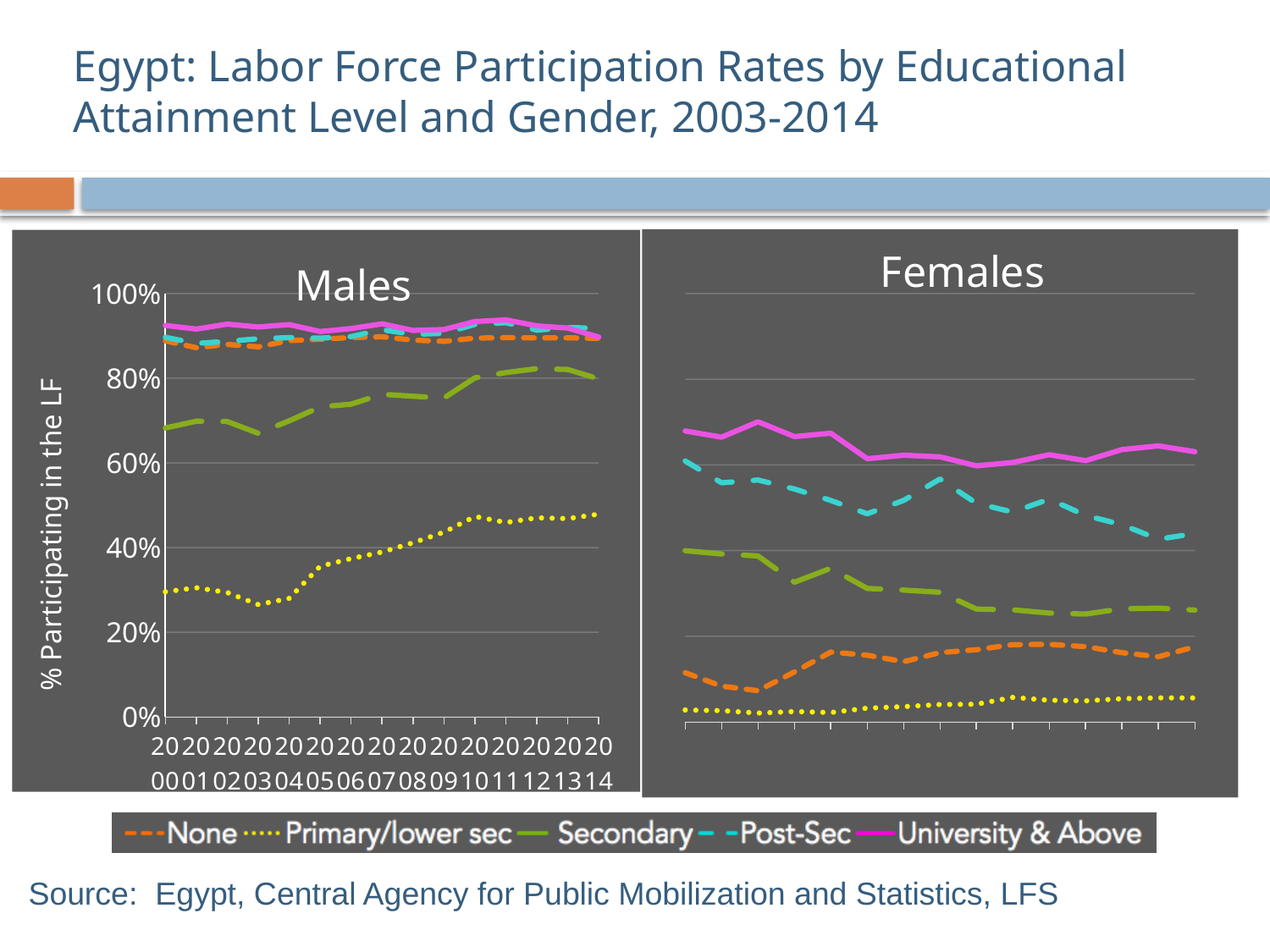
On the Males chart, which series has the highest participation rate across the period? University & Above On the Males chart, does the Primary/lower sec series rise or fall from 2000 to 2014? rise On the Males chart, is the value for Secondary in 2000 greater or less than 60%? greater On the Males chart, how many years are shown on the x axis? 15 On the Females chart, does the Post-Sec series rise or fall from 2000 to 2014? fall On the Females chart, is the value for Secondary in 2014 greater or less than 40%? less On the Males chart, which series has the lowest participation rate across the period? Primary/lower sec What kind of chart is the Males chart? line chart On the Males chart, is the value for Primary/lower sec in 2000 greater or less than 40%? less How many series does the legend list? 5 On the Females chart, which series has the lowest participation rate across the period? Primary/lower sec On the Females chart, which is larger in 2014: University & Above or Post-Sec? University & Above